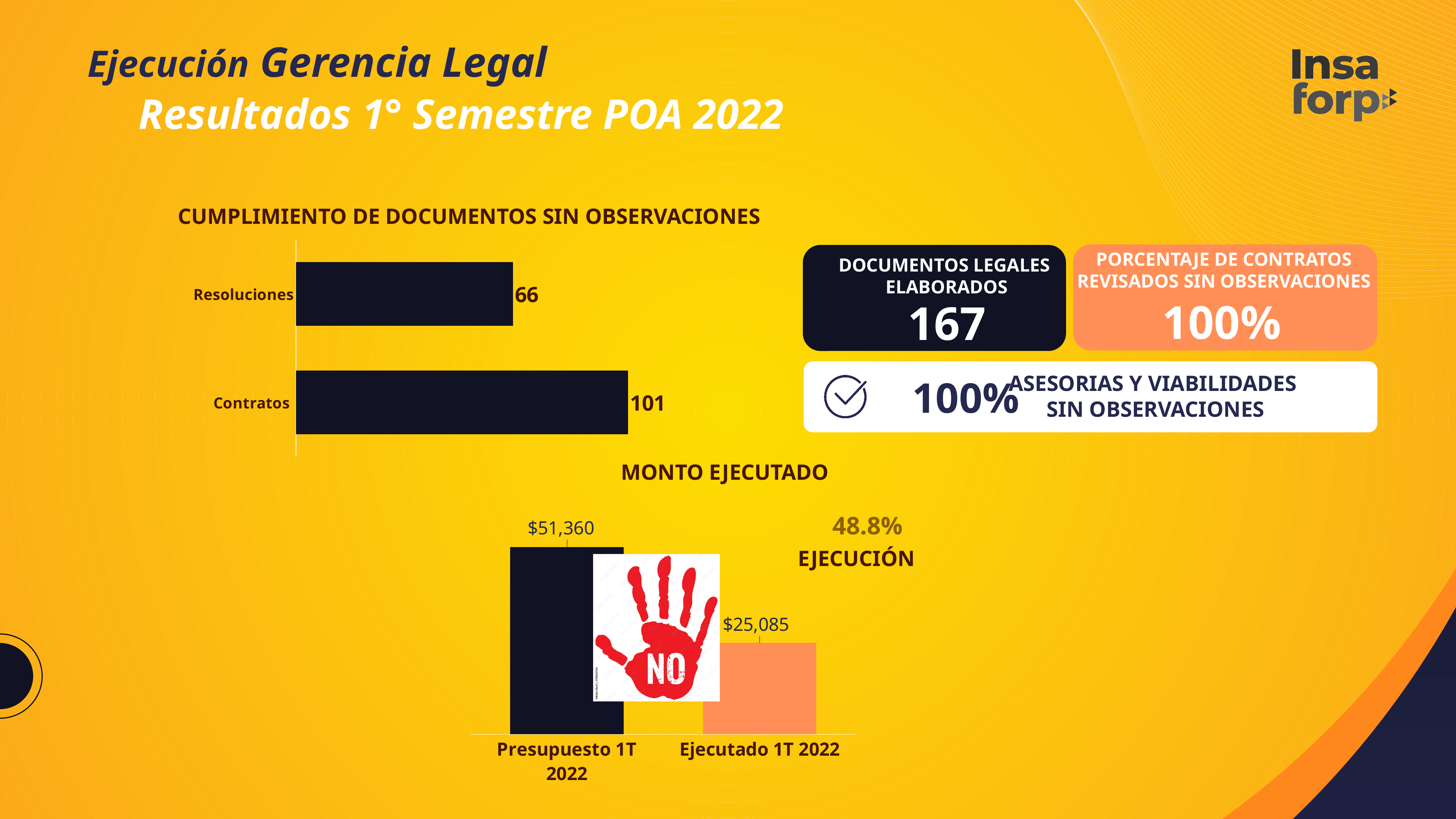
In the 'CUMPLIMIENTO DE DOCUMENTOS SIN OBSERVACIONES' chart, what is the value for Resoluciones? 66 In the 'MONTO EJECUTADO' chart, which category has the lowest value? Ejecutado 1T 2022 What kind of chart is the 'CUMPLIMIENTO DE DOCUMENTOS SIN OBSERVACIONES' chart? Bar chart In the 'MONTO EJECUTADO' chart, what is the value for Ejecutado 1T 2022? $25,085 In the 'CUMPLIMIENTO DE DOCUMENTOS SIN OBSERVACIONES' chart, which category has the highest value? Contratos In the 'CUMPLIMIENTO DE DOCUMENTOS SIN OBSERVACIONES' chart, what is the value for Contratos? 101 In the 'MONTO EJECUTADO' chart, is the value for Presupuesto 1T 2022 larger or smaller than the value for Ejecutado 1T 2022? Larger In the 'CUMPLIMIENTO DE DOCUMENTOS SIN OBSERVACIONES' chart, how many categories are shown? 2 In the 'CUMPLIMIENTO DE DOCUMENTOS SIN OBSERVACIONES' chart, what is the difference between Contratos and Resoluciones? 35 In the 'MONTO EJECUTADO' chart, what is the difference between Presupuesto 1T 2022 and Ejecutado 1T 2022? $26,275 In the 'MONTO EJECUTADO' chart, what is the value for Presupuesto 1T 2022? $51,360 What execution percentage is shown next to the 'MONTO EJECUTADO' chart? 48.8%